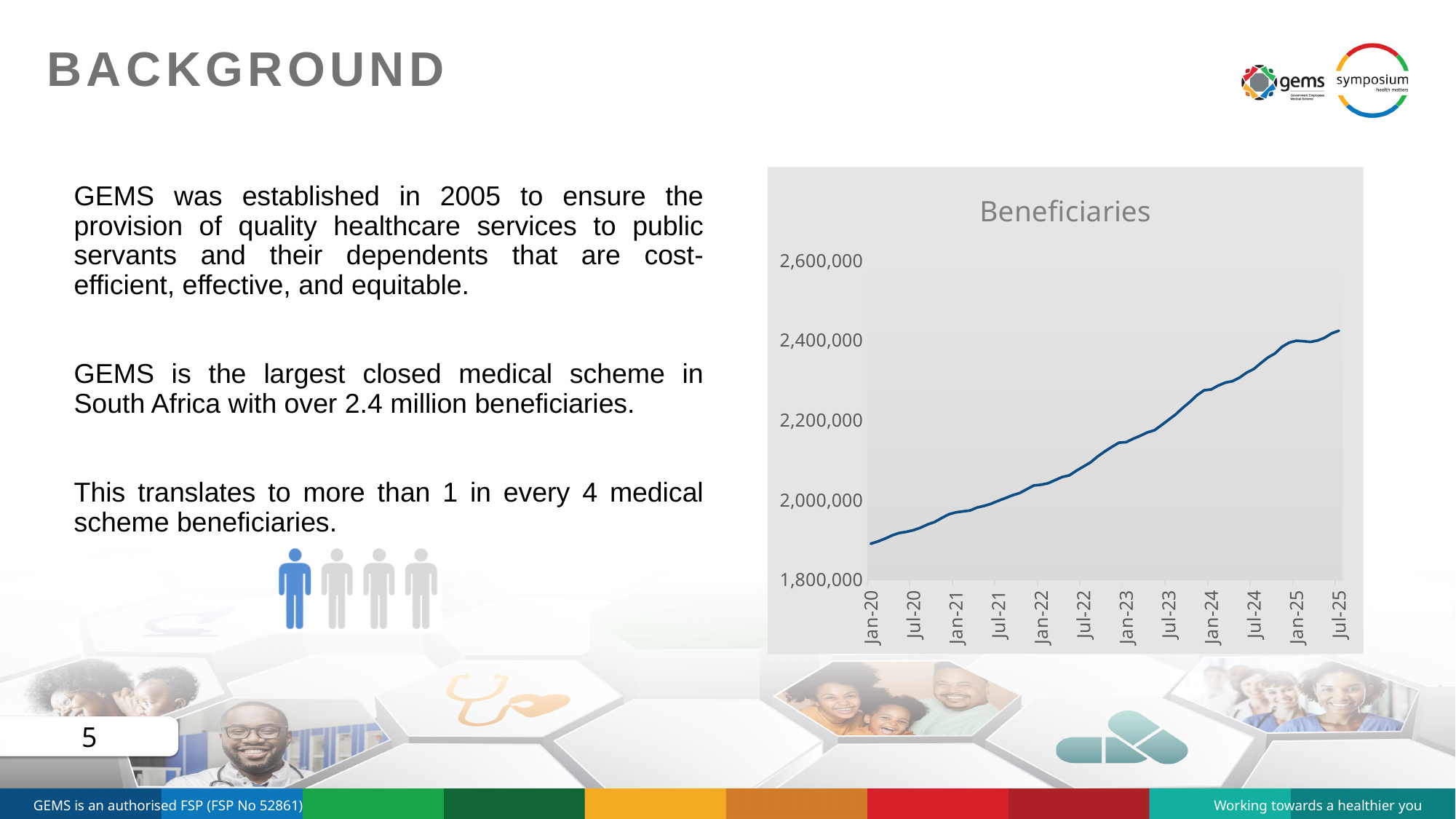
Which x-axis label in the Beneficiaries chart corresponds to the highest value? Jul-25 Do the values in the Beneficiaries chart rise or fall from Jan-20 to Jul-25? rise Is the value for Jul-24 in the Beneficiaries chart greater or less than 2,200,000? greater Is the value for Jan-23 in the Beneficiaries chart greater or less than 2,200,000? less What is the title of the chart? Beneficiaries Which is larger in the Beneficiaries chart, the value for Jan-22 or the value for Jan-24? Jan-24 Is the value for Jan-21 in the Beneficiaries chart greater or less than 2,000,000? less What kind of chart is shown on the slide? line chart Which x-axis label in the Beneficiaries chart corresponds to the lowest value? Jan-20 How many labels are shown on the x axis of the Beneficiaries chart? 12